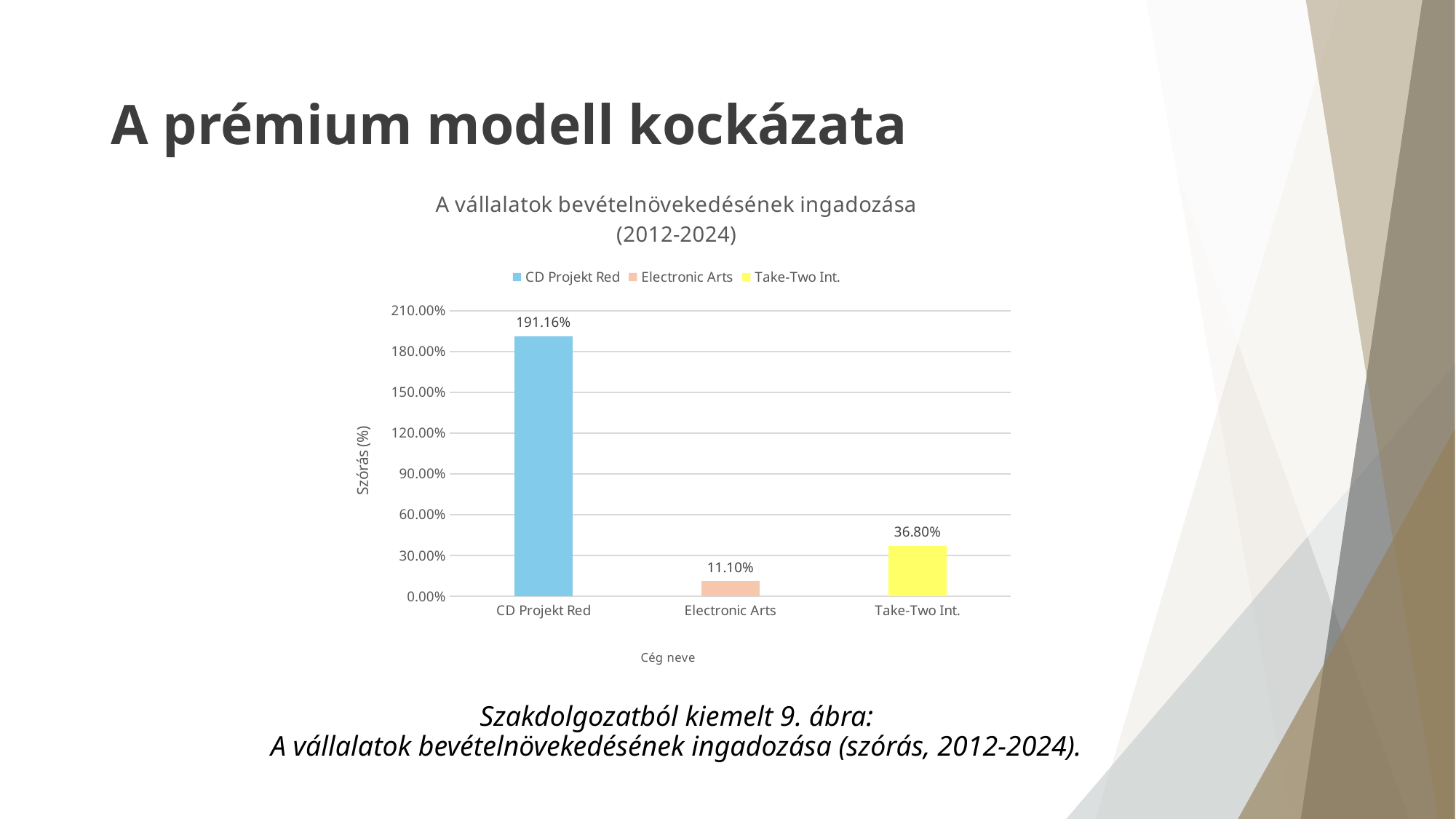
How many companies are shown on the x axis? 3 How many entries does the legend list? 3 Which company has the lowest value? Electronic Arts Which company has the highest value? CD Projekt Red What is the difference between the values for Take-Two Int. and Electronic Arts? 25.70% What is the value for Take-Two Int.? 36.80% Which is larger, the value for Electronic Arts or the value for Take-Two Int.? Take-Two Int. What is the value for CD Projekt Red? 191.16% Is the value for CD Projekt Red greater or less than 180.00%? greater What kind of chart is shown on the slide? bar chart What is the value for Electronic Arts? 11.10% What is the difference between the values for CD Projekt Red and Take-Two Int.? 154.36%